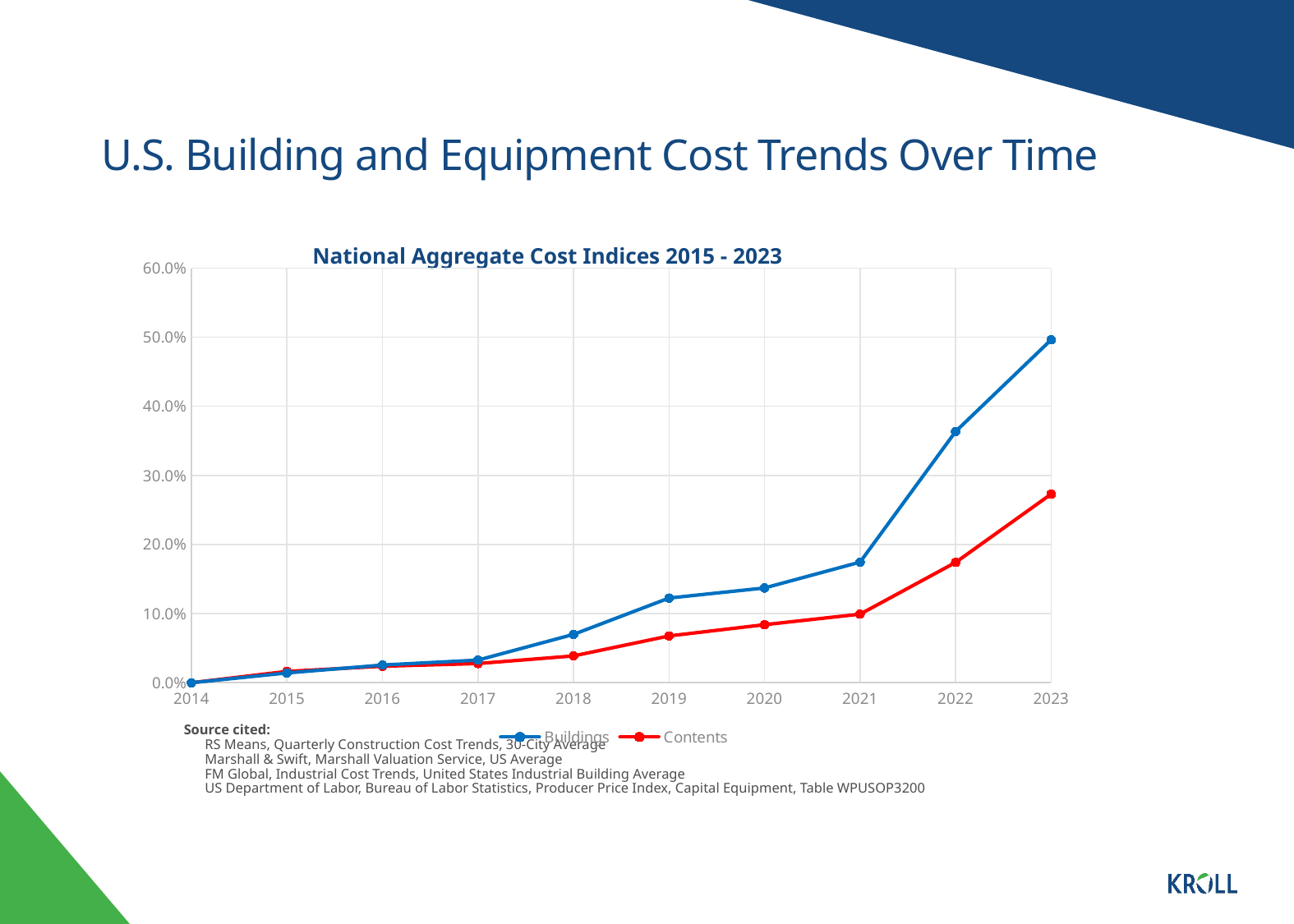
Do the Buildings values rise or fall from 2014 to 2023? rise Is the value for Buildings in 2023 greater or less than 40.0%? greater What kind of chart is shown on the slide? line chart How many years are plotted along the x axis? 10 How many series does the legend list? 2 Is the value for Contents in 2023 greater or less than 30.0%? less What is the title of the chart? National Aggregate Cost Indices 2015 - 2023 Which series is higher in 2023, Buildings or Contents? Buildings Is the value for Buildings in 2022 greater or less than 30.0%? greater Which colour is used for the Contents series? red In which year is the Buildings series at its highest? 2023 In which year is the Contents series at its lowest? 2014